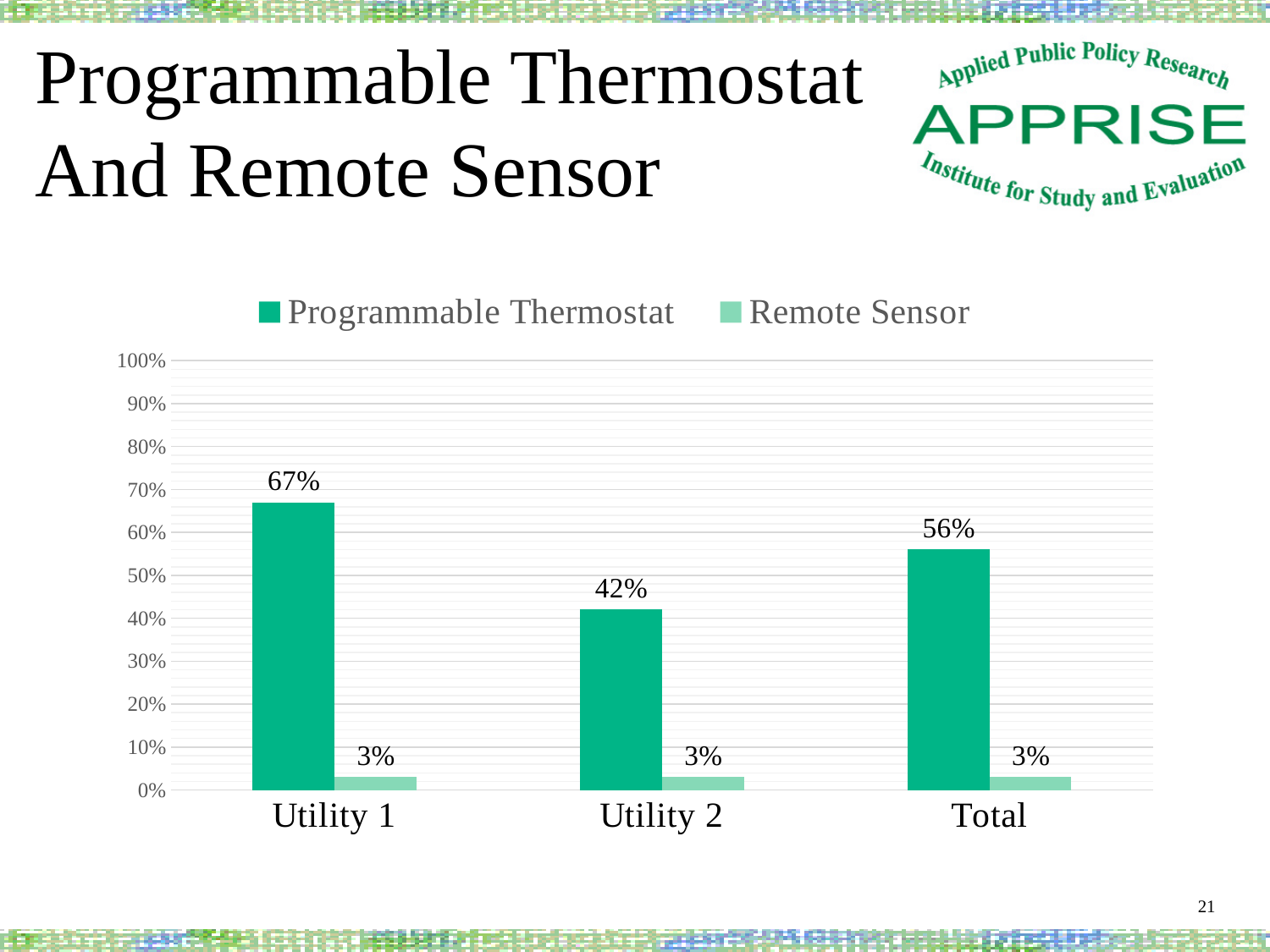
Is the Programmable Thermostat value for Total greater or less than 50%? greater What kind of chart is shown on the slide? bar chart How many series does the legend list? 2 Which category has the highest Programmable Thermostat value? Utility 1 How many categories are shown on the x axis? 3 What is the Remote Sensor value for Utility 2? 3% What is the Programmable Thermostat value for Utility 2? 42% What is the Programmable Thermostat value for Total? 56% Which is larger for Utility 1: the Programmable Thermostat value or the Remote Sensor value? Programmable Thermostat Which category has the lowest Programmable Thermostat value? Utility 2 What is the Programmable Thermostat value for Utility 1? 67% What is the difference between the Programmable Thermostat values for Utility 1 and Utility 2? 25%